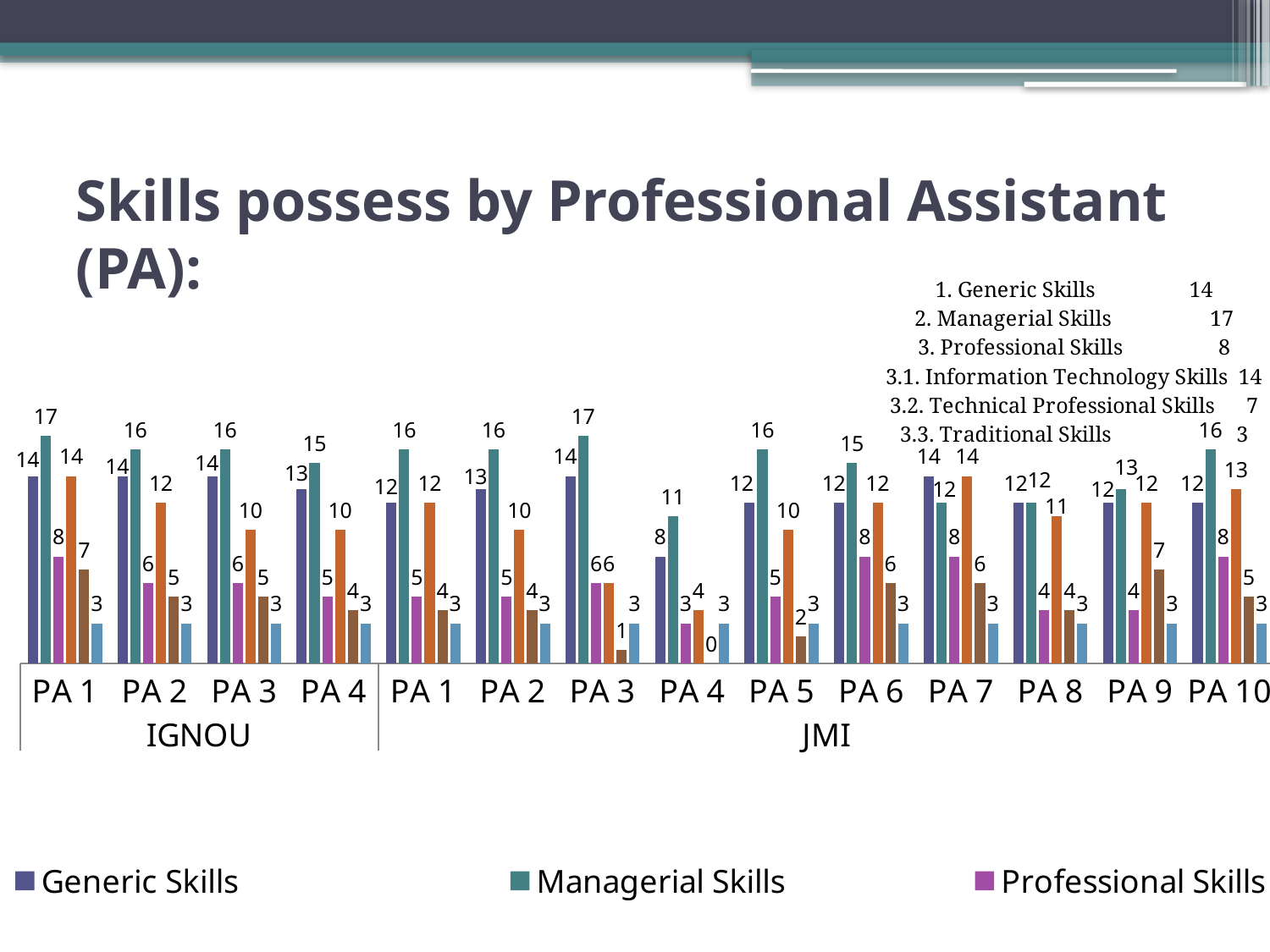
Which PA has the lowest Managerial Skills value? PA 4 (JMI) What is the Generic Skills value for PA 1 under IGNOU? 14 How many series does the legend list? 3 Which PA has the lowest Generic Skills value? PA 4 (JMI) What is the Managerial Skills value for PA 4 under JMI? 11 What are the two institution groups shown on the x axis? IGNOU and JMI What is the difference between the Managerial Skills and Generic Skills values for PA 1 under IGNOU? 3 How many PA categories are shown on the x axis in total? 14 What kind of chart is shown on the slide? Bar chart What is the Professional Skills value for PA 6 under JMI? 8 Which is larger: the Generic Skills value for PA 2 under IGNOU or for PA 2 under JMI? PA 2 under IGNOU What is the Managerial Skills value for PA 3 under JMI? 17